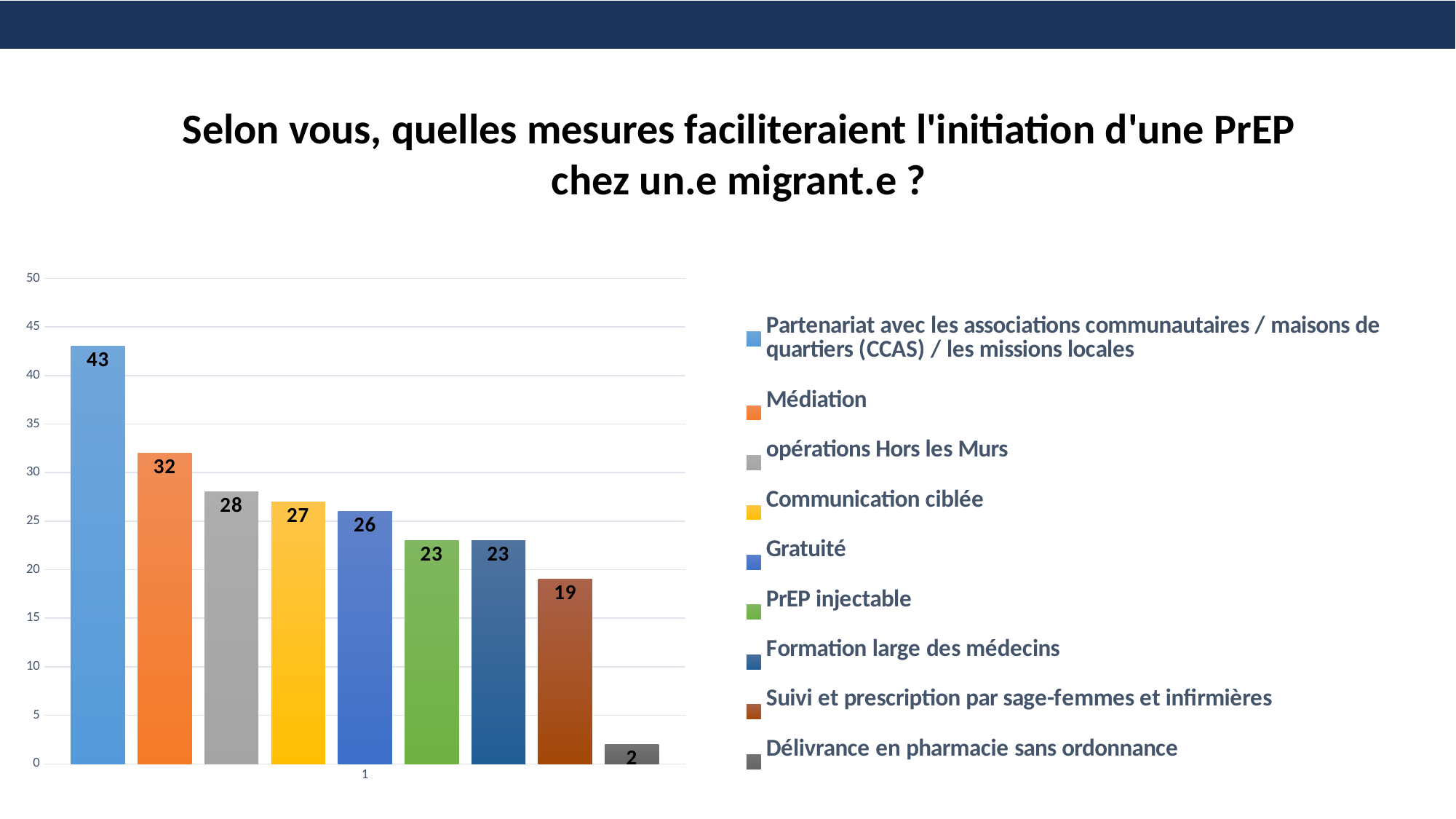
How many series does the legend list? 9 What colour is the bar for Communication ciblée? Yellow What value is shown for Gratuité? 26 What is the difference between the highest value and the value for opérations Hors les Murs? 15 What value is shown for Suivi et prescription par sage-femmes et infirmières? 19 Which measure has the lowest value? Délivrance en pharmacie sans ordonnance Which is larger, the value for PrEP injectable or the value for Suivi et prescription par sage-femmes et infirmières? PrEP injectable What kind of chart is shown on the slide? Bar chart What value is shown for Médiation? 32 What value is shown for Délivrance en pharmacie sans ordonnance? 2 What is the difference between the values for Médiation and Communication ciblée? 5 Which measure has the highest value? Partenariat avec les associations communautaires / maisons de quartiers (CCAS) / les missions locales